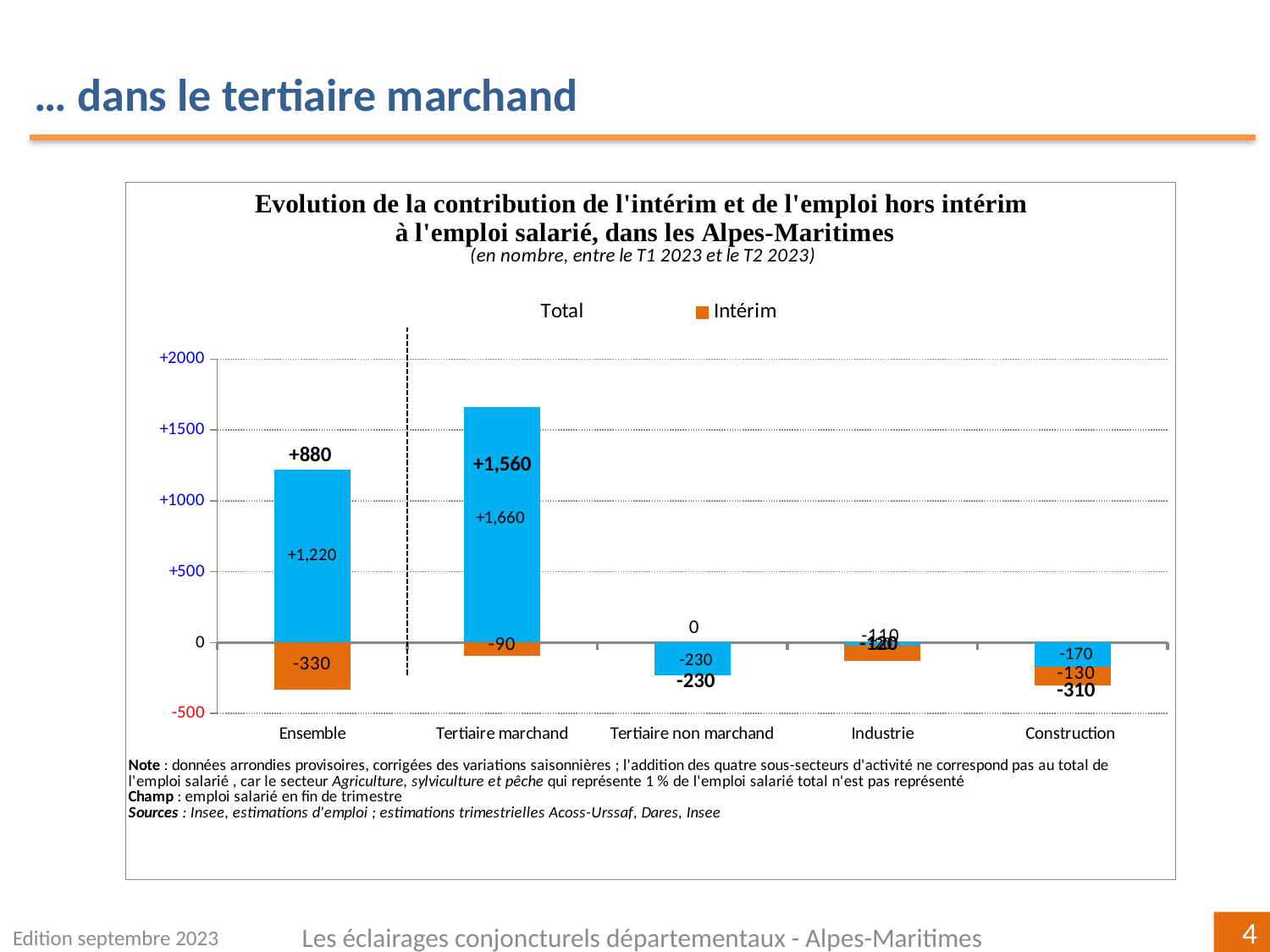
What is the Total value for Tertiaire marchand? +1,560 Which category has the larger Intérim decline, Ensemble or Tertiaire marchand? Ensemble Which two entries does the chart legend list? Total and Intérim What is the Intérim value for Ensemble? -330 What is the difference between the Total values for Tertiaire marchand and Ensemble? 680 What is the Intérim value for Tertiaire marchand? -90 What is the Intérim value for Construction? -130 What is the value of the blue bar for Ensemble? +1,220 Which category has the highest Total value? Tertiaire marchand What is the Total value for Construction? -310 What kind of chart is shown on the slide? bar chart How many categories are shown on the x axis of the chart? 5